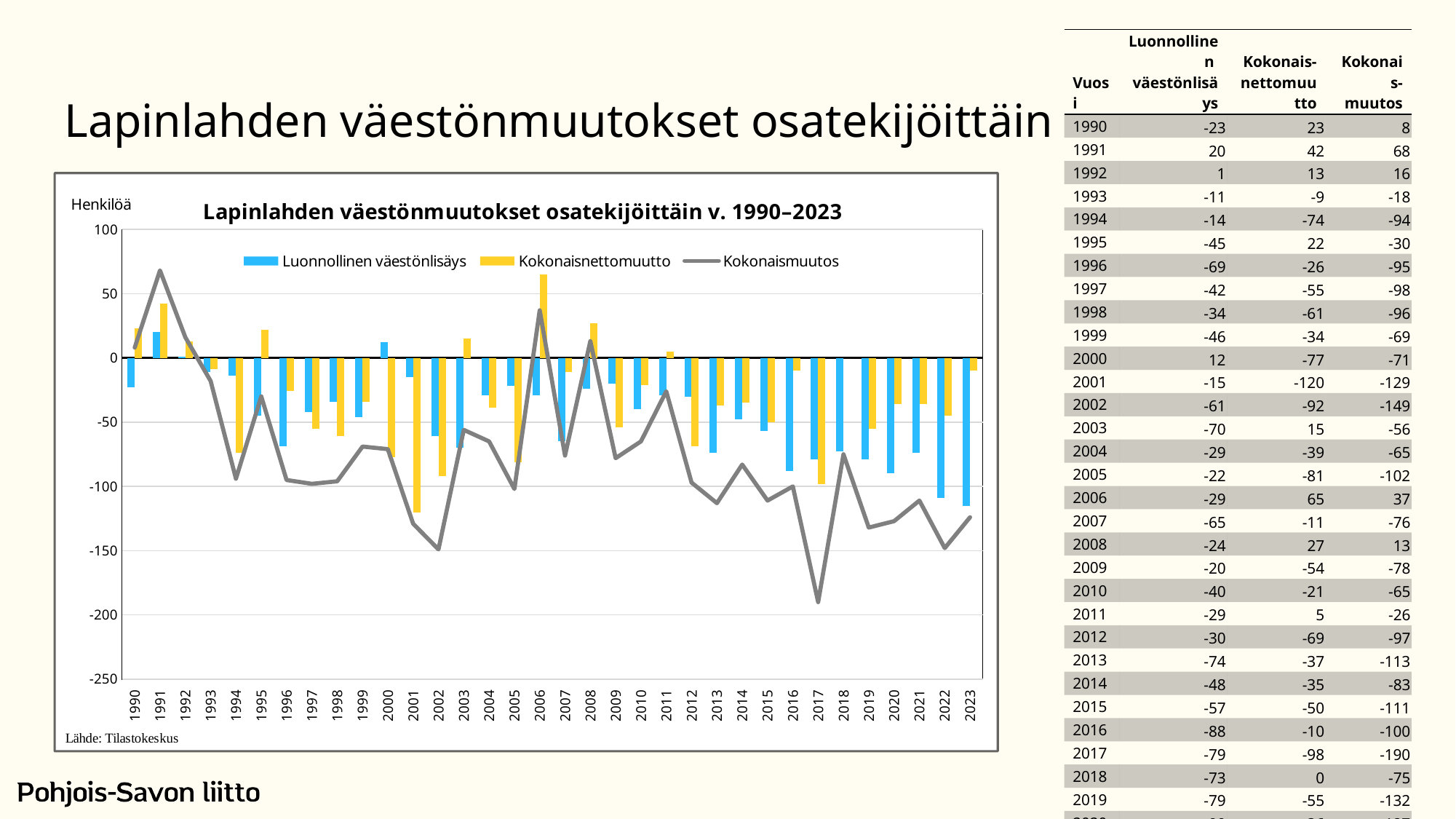
How many years are plotted along the x axis of the chart? 34 In which year is the Kokonaismuutos line at its lowest? 2017 What is the Kokonaismuutos value for 2017? -190 What is the title of the chart? Lapinlahden väestönmuutokset osatekijöittäin v. 1990–2023 Which year has the larger Kokonaismuutos value, 1991 or 2006? 1991 Is the Kokonaisnettomuutto value for 2001 greater or less than -100? less In which year is the Kokonaismuutos line at its highest? 1991 What kind of chart is shown on the slide? bar and line chart What is the Luonnollinen väestönlisäys value for 2016? -88 Is the Kokonaismuutos value for 2017 greater or less than -150? less How many series does the chart legend list? 3 What is the difference between the Kokonaismuutos values for 2001 and 2002? 20